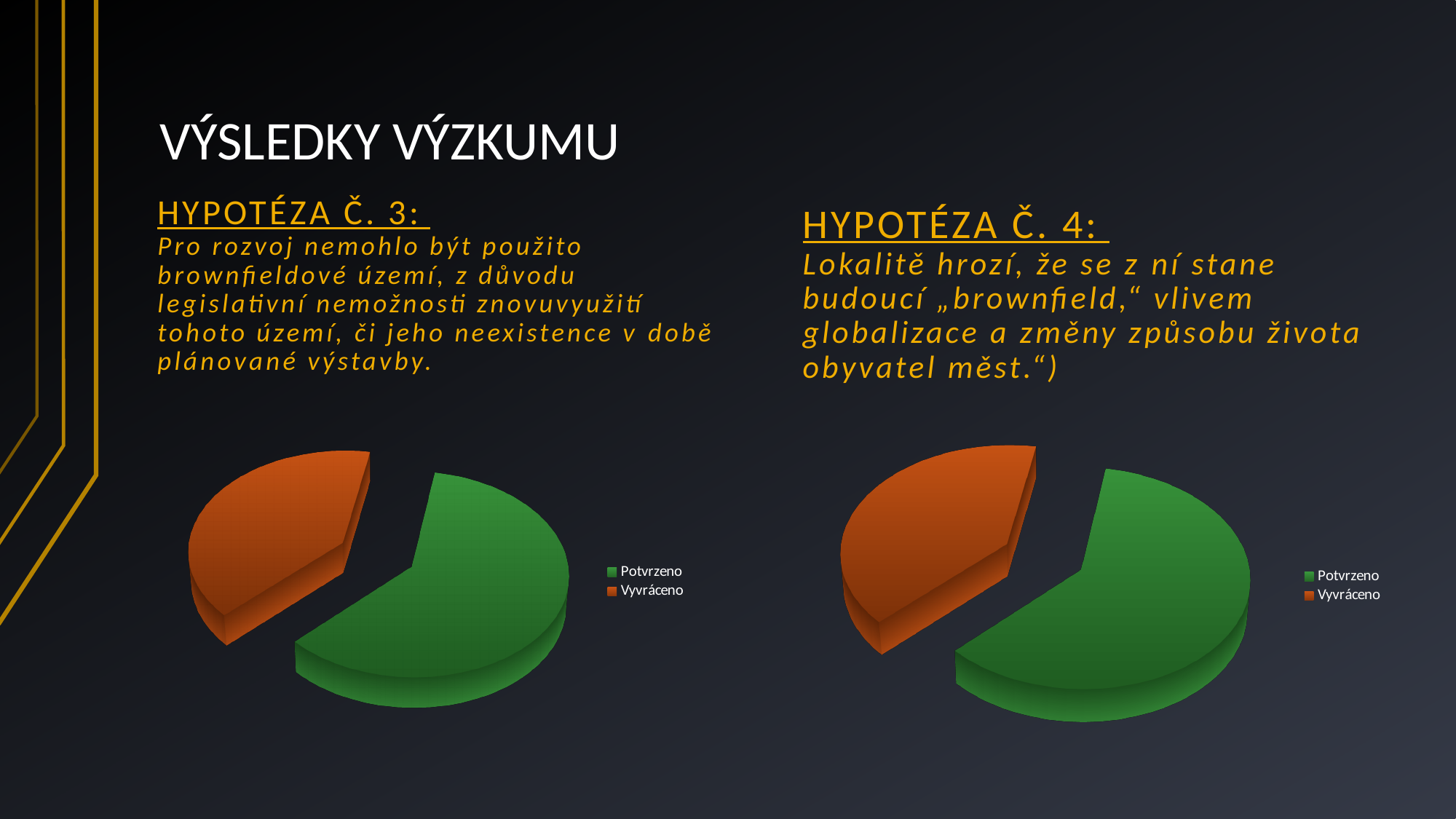
In the pie chart under Hypotéza č. 3, what colour represents Vyvráceno? Orange In the pie chart under Hypotéza č. 3, which slice is the largest? Potvrzeno In the pie chart under Hypotéza č. 4, how many slices are there? 2 How many entries does the legend of the pie chart under Hypotéza č. 3 list? 2 In the pie chart under Hypotéza č. 4, is the Potvrzeno slice or the Vyvráceno slice larger? Potvrzeno How many entries does the legend of the pie chart under Hypotéza č. 4 list? 2 What kind of chart is shown under Hypotéza č. 3? Pie chart In the pie chart under Hypotéza č. 3, which slice is the smallest? Vyvráceno In the pie chart under Hypotéza č. 4, which slice is the largest? Potvrzeno In the pie chart under Hypotéza č. 4, what colour represents Potvrzeno? Green In the pie chart under Hypotéza č. 3, how many slices are there? 2 What kind of chart is shown under Hypotéza č. 4? Pie chart